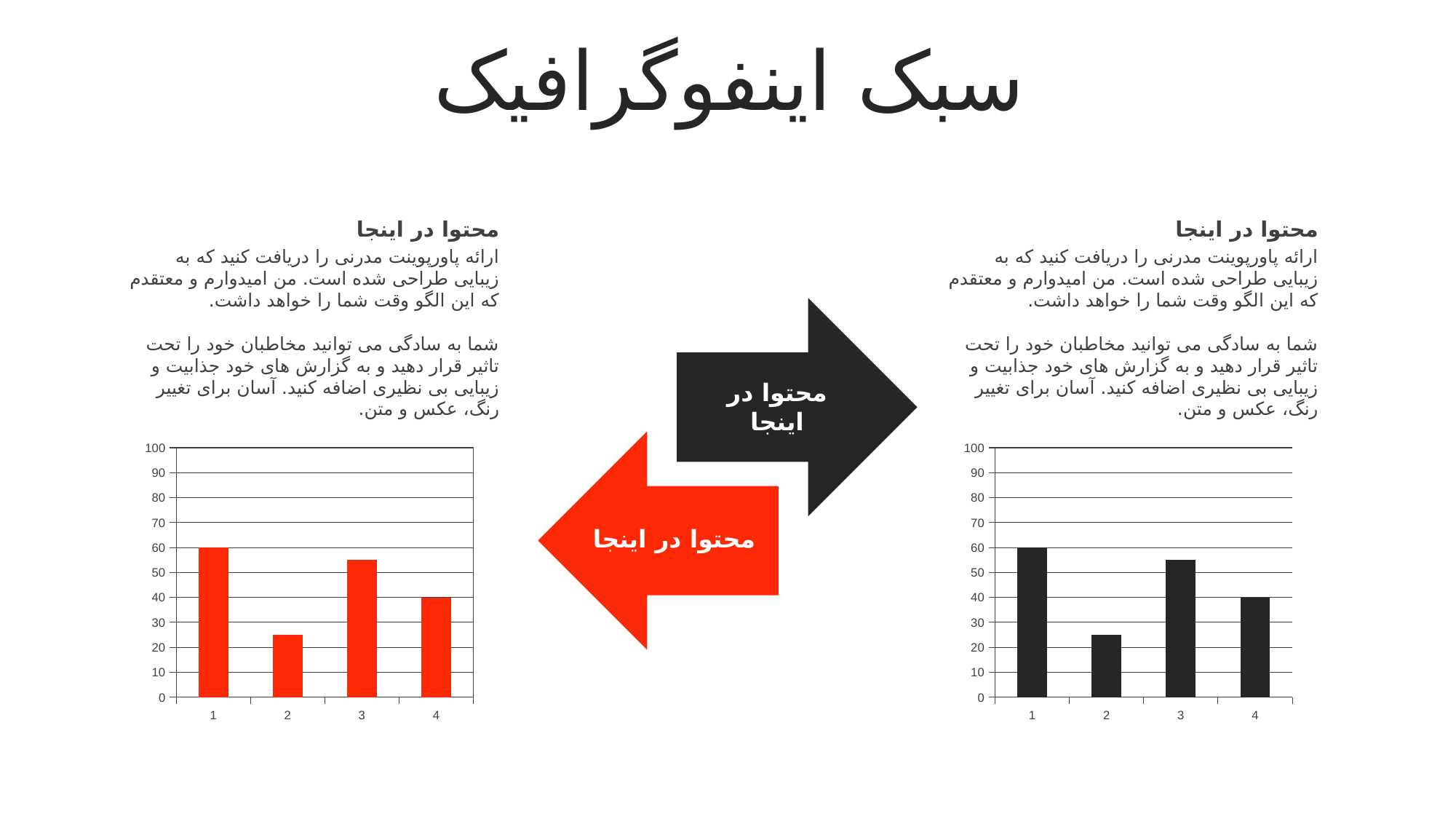
On the left chart, what is the difference between the values for category 1 and category 4? 20 On the right chart, what is the value for category 4? 40 On the left chart, which category has the lowest value? 2 How many categories are shown on the left chart? 4 On the right chart, which is larger, the value for category 3 or the value for category 4? category 3 What colour are the bars on the left chart? red On the right chart, is the value for category 3 greater or less than 50? greater On the left chart, what is the value for category 1? 60 On the left chart, is the value for category 2 greater or less than 30? less What kind of chart is the right chart? bar chart What is the highest value shown on the vertical axis of the right chart? 100 On the right chart, which category has the highest value? 1